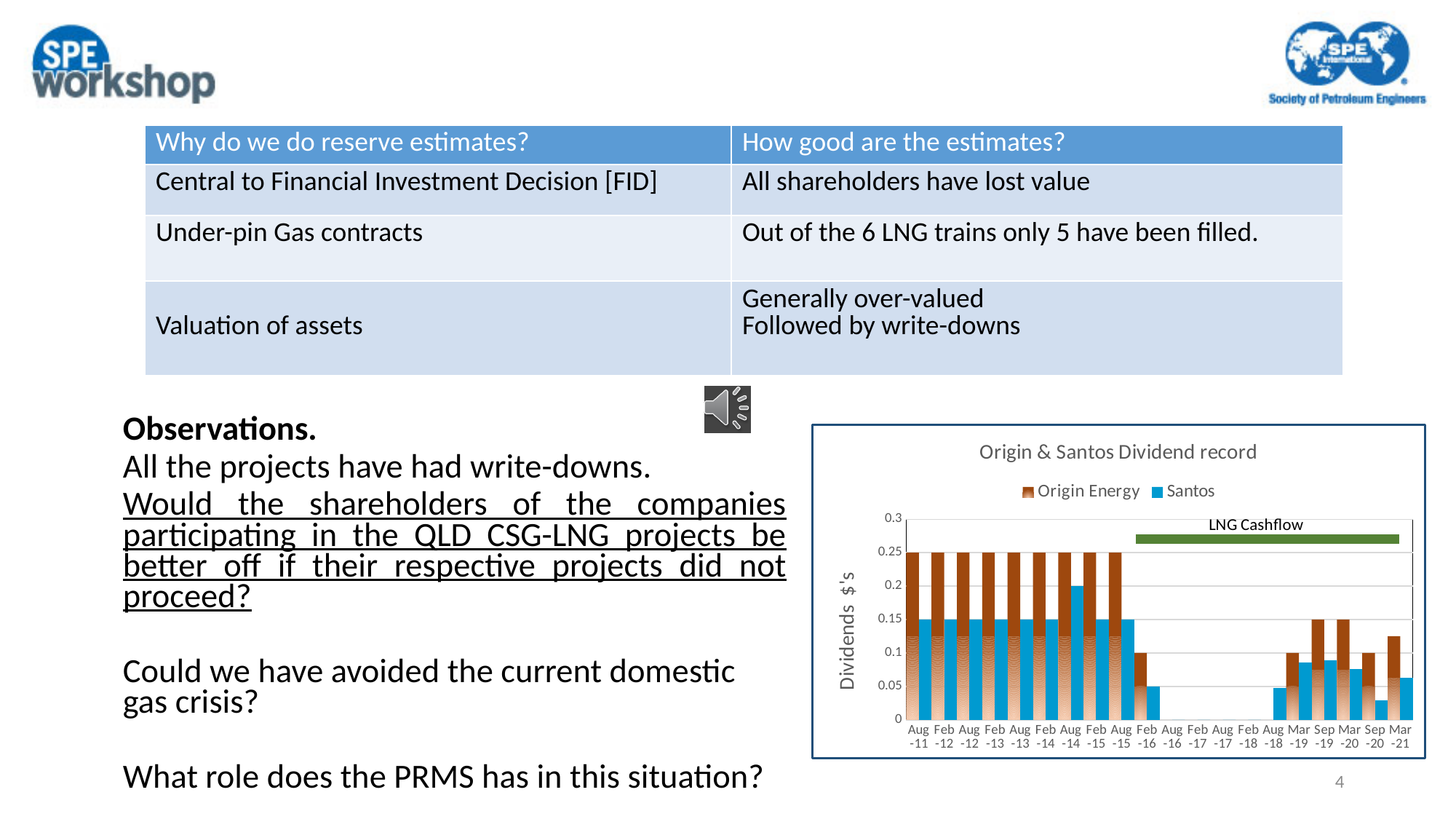
What is the Origin Energy dividend value for Feb-16? 0.1 How many series does the chart legend list? 2 Is the Origin Energy value for Mar-21 greater or less than 0.1? greater What type of chart is shown on the slide? bar chart Is the Santos value for Sep-20 greater or less than 0.05? less What is the label on the y axis of the chart? Dividends $'s What is the Santos dividend value for Aug-11? 0.15 What is the Santos dividend value for Aug-14? 0.2 How many date categories are shown on the x axis of the chart? 20 What is the title of the chart? Origin & Santos Dividend record Which series has the larger value for Aug-11, Origin Energy or Santos? Origin Energy What is the Origin Energy dividend value for Aug-11? 0.25